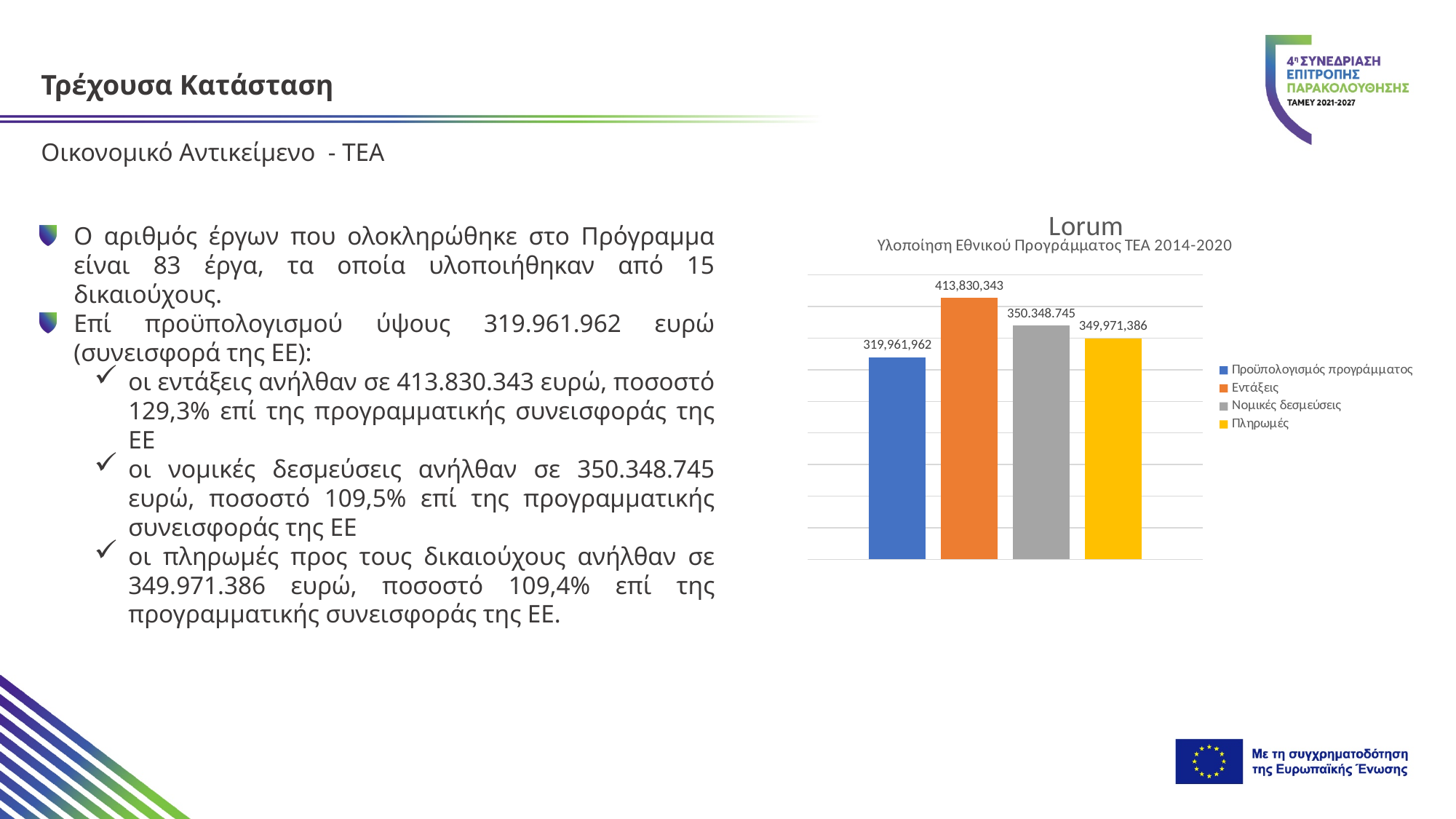
Which is larger, the Εντάξεις bar or the Πληρωμές bar? Εντάξεις What is the value of the Νομικές δεσμεύσεις bar? 350.348.745 Which series has the lowest value in the chart? Προϋπολογισμός προγράμματος How many series does the chart legend list? 4 What type of chart is shown on the slide? bar chart What is the difference between the Εντάξεις value and the Προϋπολογισμός προγράμματος value? 93,868,381 Which series has the highest value in the chart? Εντάξεις What is the difference between the Νομικές δεσμεύσεις value and the Πληρωμές value? 377,359 What is the value of the Πληρωμές bar? 349,971,386 What is the value of the Εντάξεις bar? 413,830,343 What colour is the Εντάξεις bar? orange What is the value of the Προϋπολογισμός προγράμματος bar? 319,961,962